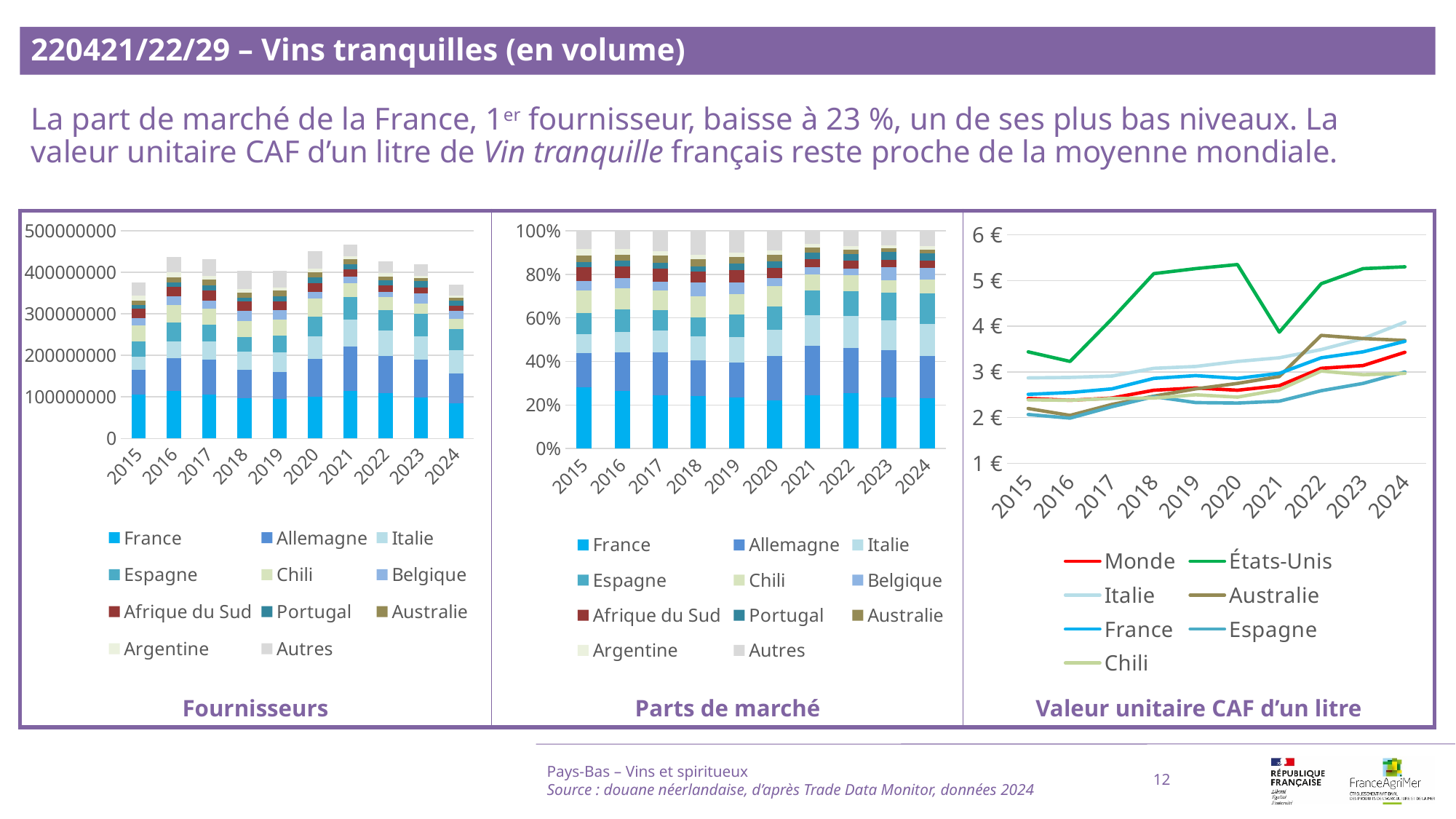
What kind of chart is the 'Fournisseurs' chart? bar chart In the 'Fournisseurs' chart, is the total for 2024 greater or less than 400000000? less In the 'Valeur unitaire CAF d'un litre' chart, which series is drawn in green? États-Unis In the 'Valeur unitaire CAF d'un litre' chart, is the value for États-Unis in 2024 greater or less than 5 €? greater In the 'Fournisseurs' chart, which year has the highest total stacked bar? 2021 In the 'Valeur unitaire CAF d'un litre' chart, does the États-Unis line rise or fall from 2021 to 2024? rise What kind of chart is the 'Valeur unitaire CAF d'un litre' chart? line chart How many years are shown on the x axis of the 'Parts de marché' chart? 10 In the 'Valeur unitaire CAF d'un litre' chart, which series has the highest value in 2024? États-Unis In the 'Valeur unitaire CAF d'un litre' chart, which is larger in 2024: Italie or Monde? Italie How many series does the legend of the 'Valeur unitaire CAF d'un litre' chart list? 7 How many series does the legend of the 'Fournisseurs' chart list? 11